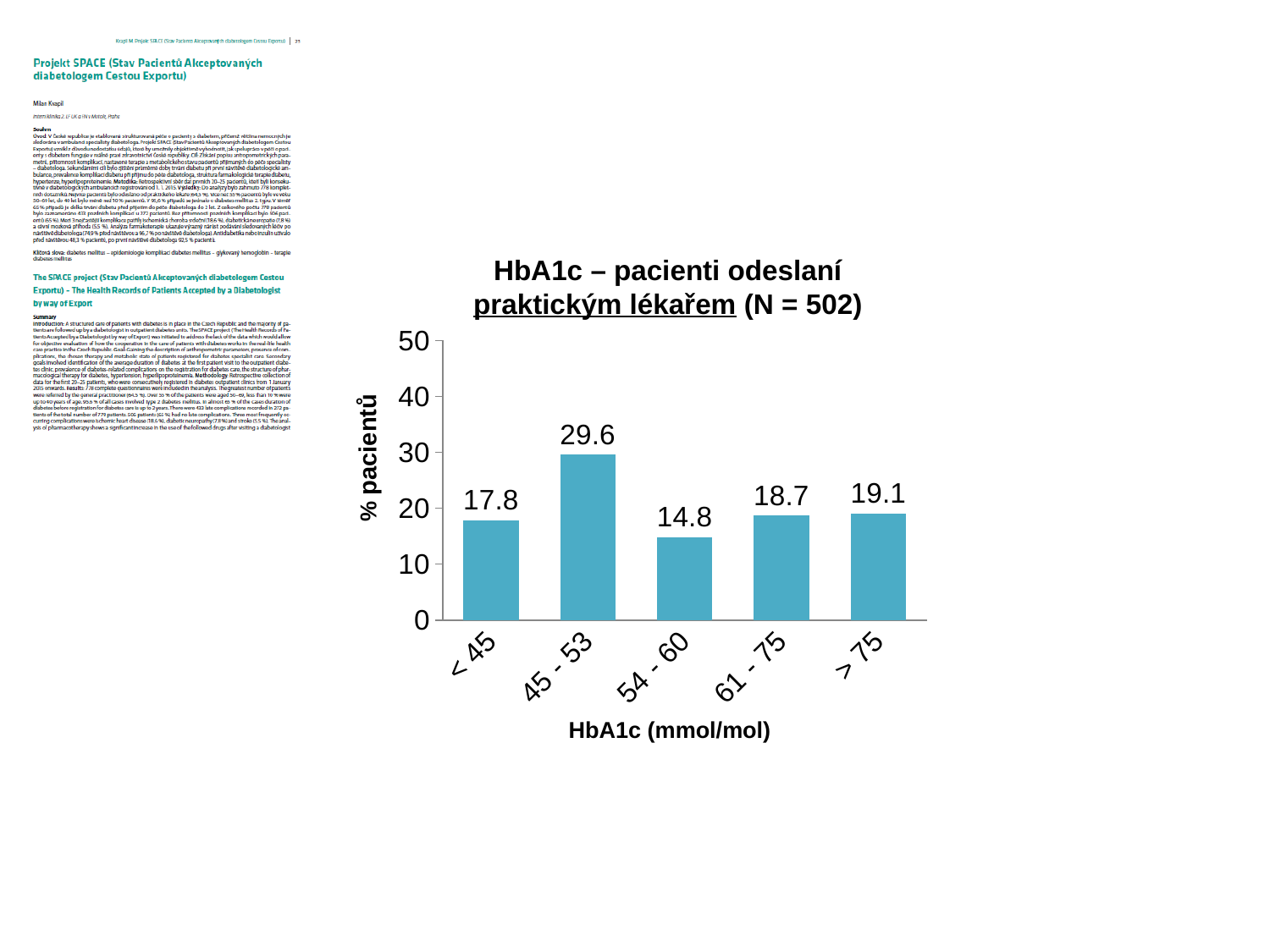
What kind of chart is shown on the slide? bar chart What is the value for the HbA1c category > 75? 19.1 Which HbA1c category has the lowest percentage of patients? 54 - 60 What is the label of the y axis of the chart? % pacientů What is the difference between the values for 45 - 53 and 54 - 60? 14.8 What is the value for the HbA1c category 45 - 53? 29.6 Is the value for 45 - 53 greater or less than 20? greater Which HbA1c category has the highest percentage of patients? 45 - 53 What is the value for the HbA1c category < 45? 17.8 What is the difference between the values for > 75 and 61 - 75? 0.4 How many HbA1c categories are shown on the x axis? 5 Which is larger, the value for < 45 or the value for 61 - 75? 61 - 75